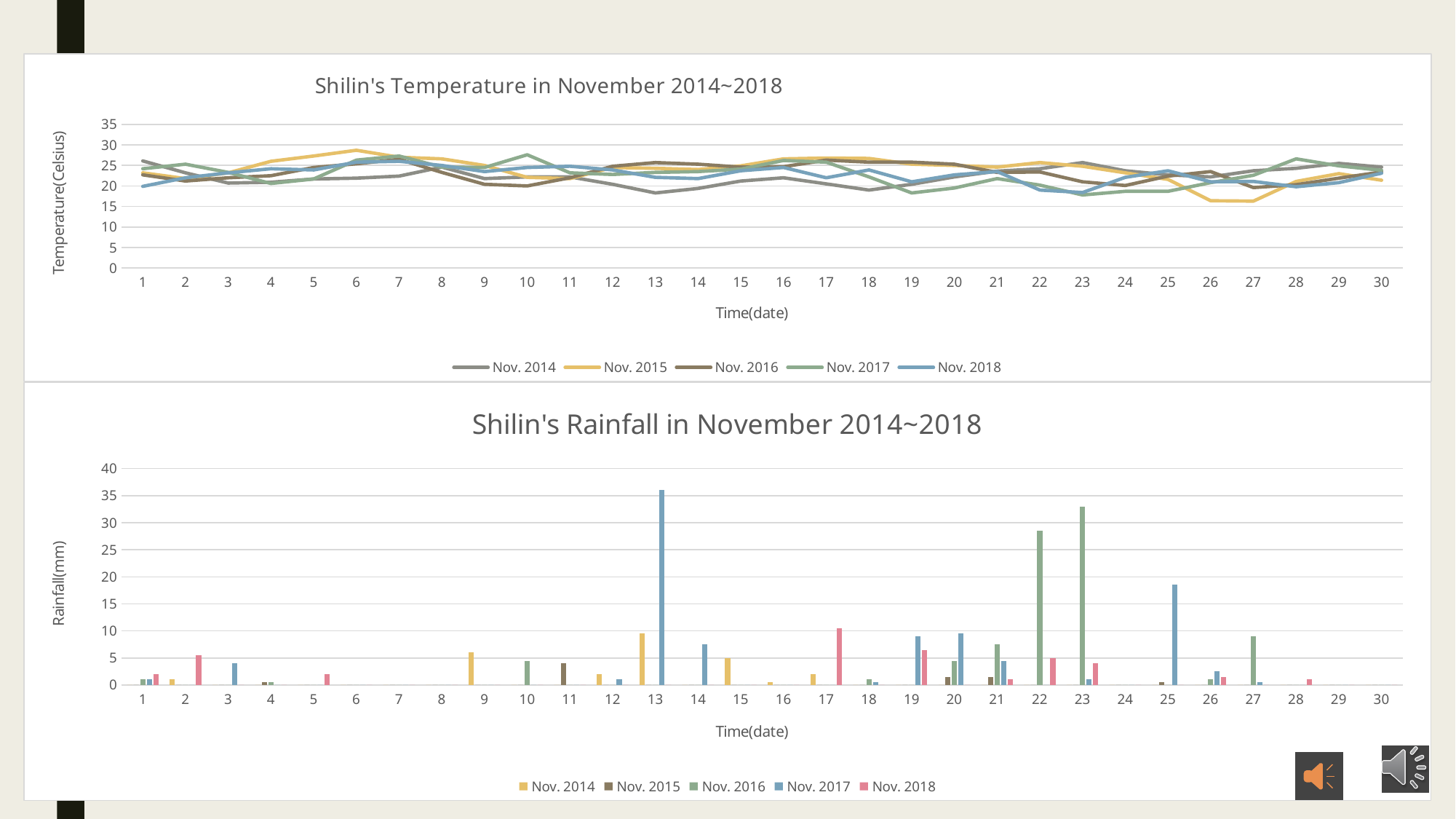
In the rainfall chart, which series has the tallest bar on date 23? Nov. 2016 In the temperature chart, which series has the highest value on date 6? Nov. 2015 What kind of chart is the top chart, 'Shilin's Temperature in November 2014~2018'? line chart In the temperature chart, is the value for Nov. 2015 on date 26 greater or less than 20? less What kind of chart is the bottom chart, 'Shilin's Rainfall in November 2014~2018'? bar chart What is the y-axis label of the rainfall chart? Rainfall(mm) In the rainfall chart, how many dates are shown on the x axis? 30 In the temperature chart, is the value for Nov. 2015 on date 6 greater or less than 25? greater In the rainfall chart, is the value for Nov. 2017 on date 13 greater or less than 30? greater In the temperature chart, how many series does the legend list? 5 In the rainfall chart, on which date does the tallest bar of the whole chart occur? 13